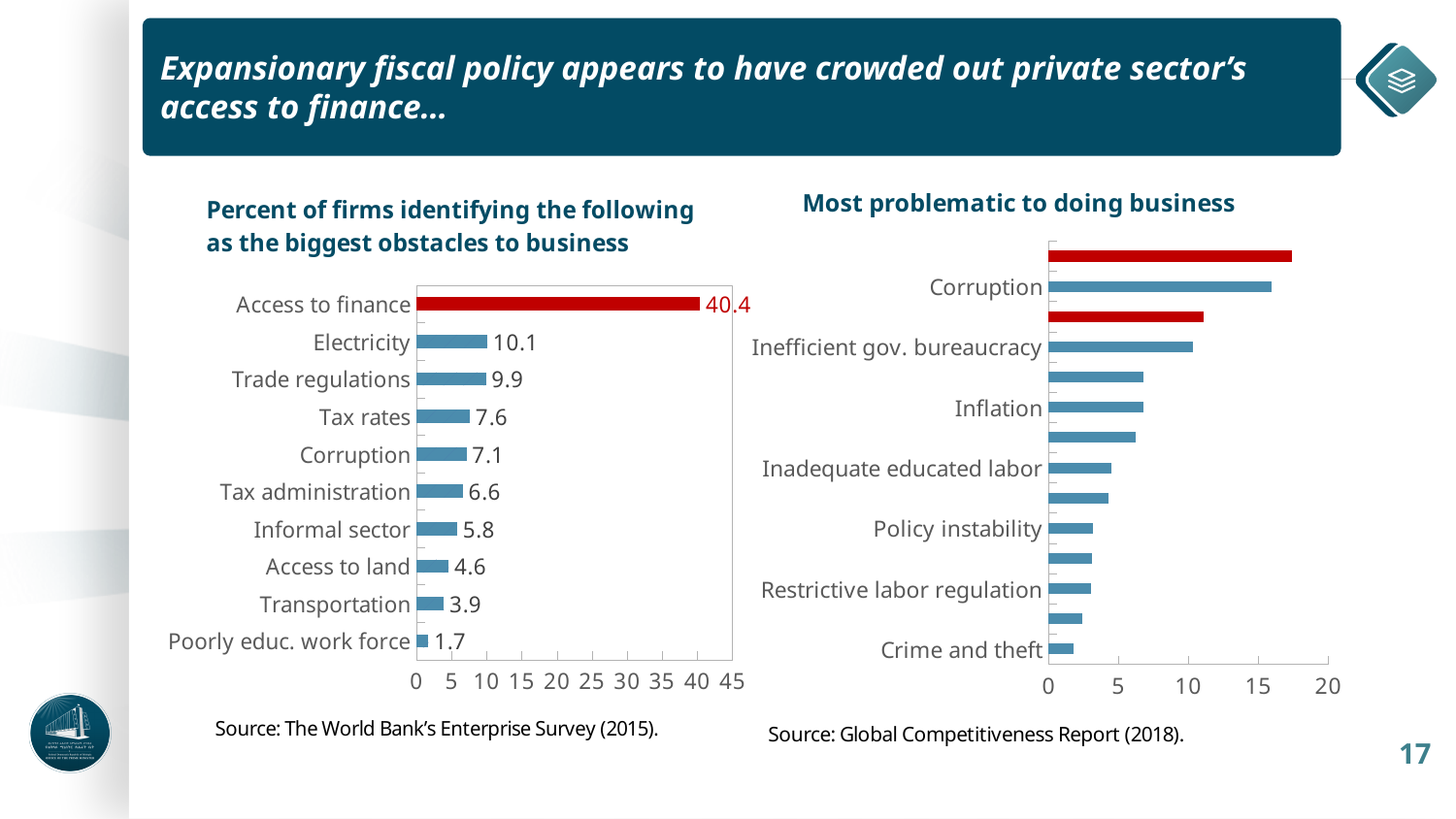
How many categories are shown in the chart 'Percent of firms identifying the following as the biggest obstacles to business'? 10 In the chart 'Percent of firms identifying the following as the biggest obstacles to business', which bar is coloured red? Access to finance In the chart 'Percent of firms identifying the following as the biggest obstacles to business', which category has the lowest value? Poorly educ. work force In the chart 'Percent of firms identifying the following as the biggest obstacles to business', which is larger: Tax rates or Tax administration? Tax rates In the chart 'Percent of firms identifying the following as the biggest obstacles to business', what is the difference between Electricity and Trade regulations? 0.2 In the chart 'Percent of firms identifying the following as the biggest obstacles to business', what is the value for Transportation? 3.9 What kind of chart is 'Most problematic to doing business'? Bar chart In the chart 'Percent of firms identifying the following as the biggest obstacles to business', what is the value for Access to finance? 40.4 In the chart 'Percent of firms identifying the following as the biggest obstacles to business', what is the value for Corruption? 7.1 In the chart 'Most problematic to doing business', is the value for Corruption greater or less than 10? greater In the chart 'Percent of firms identifying the following as the biggest obstacles to business', which category has the highest value? Access to finance In the chart 'Most problematic to doing business', is the value for Crime and theft greater or less than 5? less